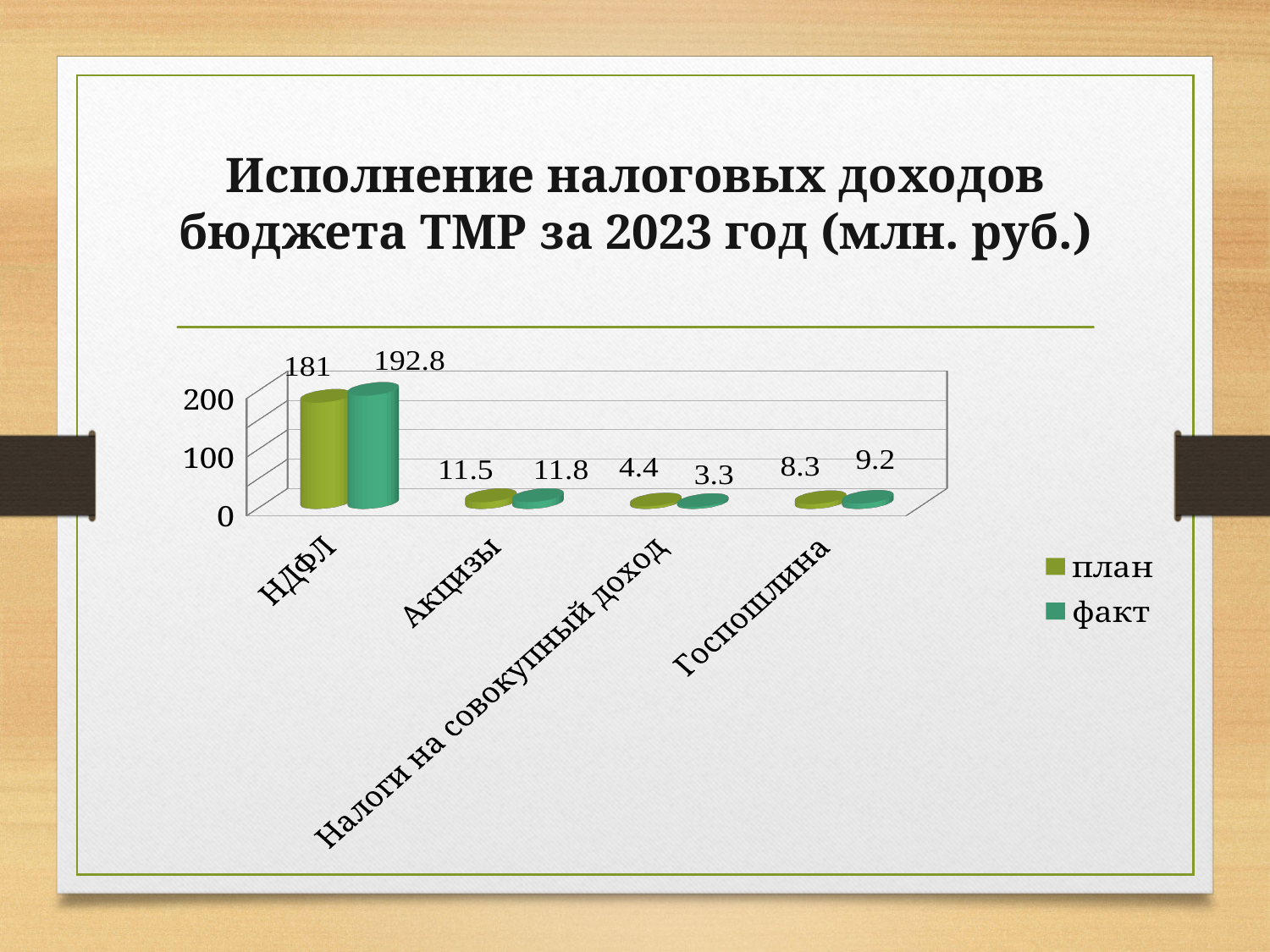
What is the difference between the факт and план values for НДФЛ? 11.8 How many series does the legend list? 2 What is the факт value for Акцизы? 11.8 What is the план value for Налоги на совокупный доход? 4.4 What kind of chart is shown on the slide? bar chart What is the факт value for Госпошлина? 9.2 Which category has the lowest план value? Налоги на совокупный доход Which category has the highest факт value? НДФЛ What is the факт value for НДФЛ? 192.8 For Налоги на совокупный доход, which is larger: план or факт? план What is the план value for НДФЛ? 181 How many categories are shown on the x axis? 4